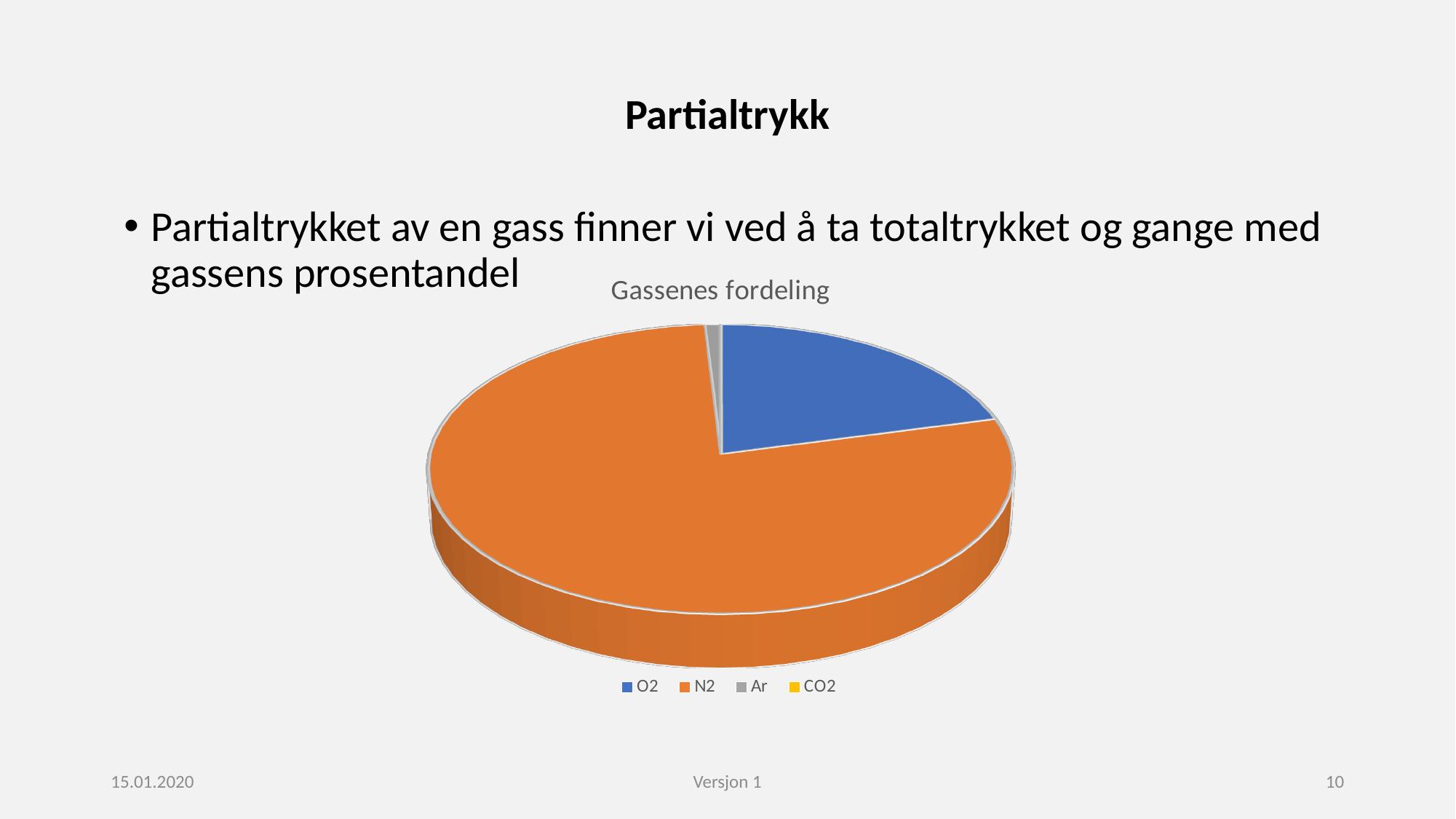
Which slice is larger, O2 or Ar? O2 Which gas has the largest slice in the pie chart? N2 Which slice is larger, O2 or N2? N2 Which slice is larger, N2 or Ar? N2 Which colour represents N2 in the pie chart? orange What kind of chart is shown on the slide? pie chart Which gas is shown in blue in the pie chart? O2 Which gas is listed first in the legend? O2 How many categories does the legend of the pie chart list? 4